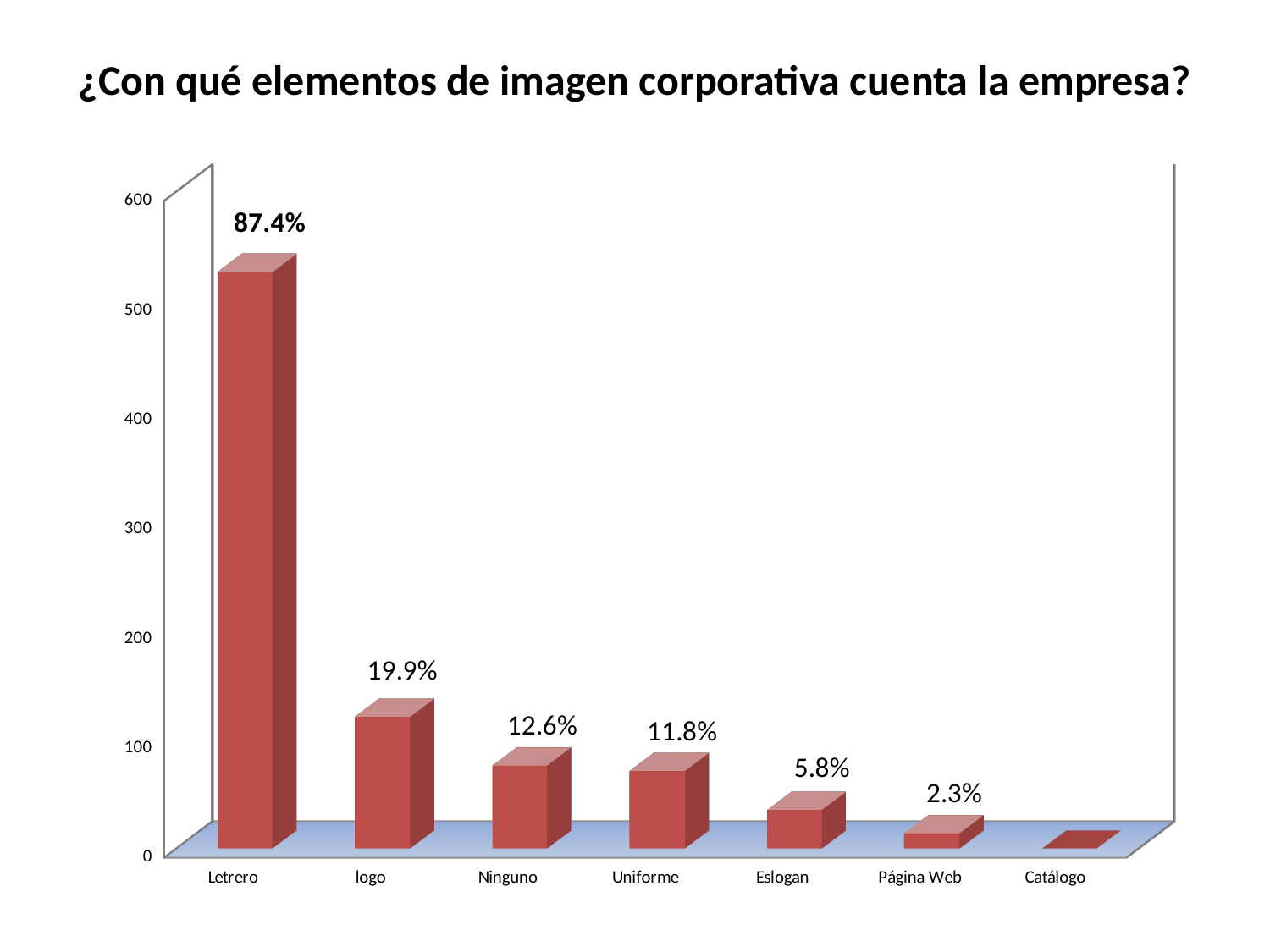
Which category has the lowest bar? Catálogo What is the data label shown for logo? 19.9% Which has the larger labelled value, Ninguno or Uniforme? Ninguno What is the difference between the labelled values for Letrero and logo? 67.5% Is the bar for logo greater or less than 200 on the vertical axis? less What is the data label shown for Eslogan? 5.8% Which category has the highest bar? Letrero How many categories are shown on the x axis? 7 What is the data label shown for Página Web? 2.3% What kind of chart is shown on the slide? Bar chart Is the bar for Letrero greater or less than 500 on the vertical axis? greater What is the data label shown for Letrero? 87.4%